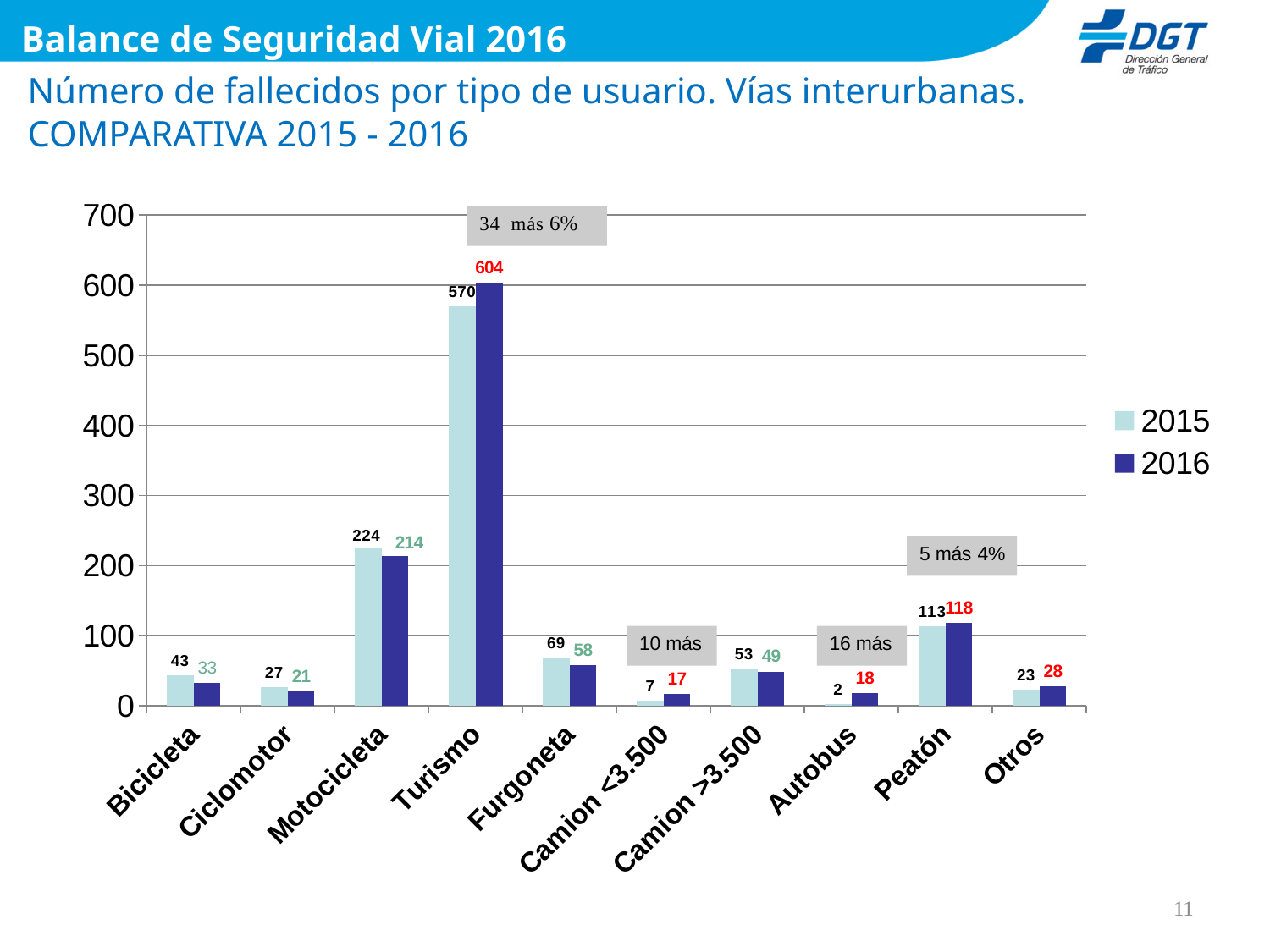
Which is larger for Furgoneta, the 2015 value or the 2016 value? 2015 What is the value for Motocicleta in 2015? 224 What is the value for Autobus in 2016? 18 What is the value for Turismo in 2016? 604 How many categories are shown on the x axis? 10 How many series does the legend list? 2 Which category has the highest value in 2016? Turismo Which is larger for Peatón, the 2015 value or the 2016 value? 2016 What is the difference between the 2016 and 2015 values for Turismo? 34 Which category has the lowest value in 2015? Autobus What kind of chart is shown on the slide? Bar chart What is the difference between the 2015 and 2016 values for Bicicleta? 10